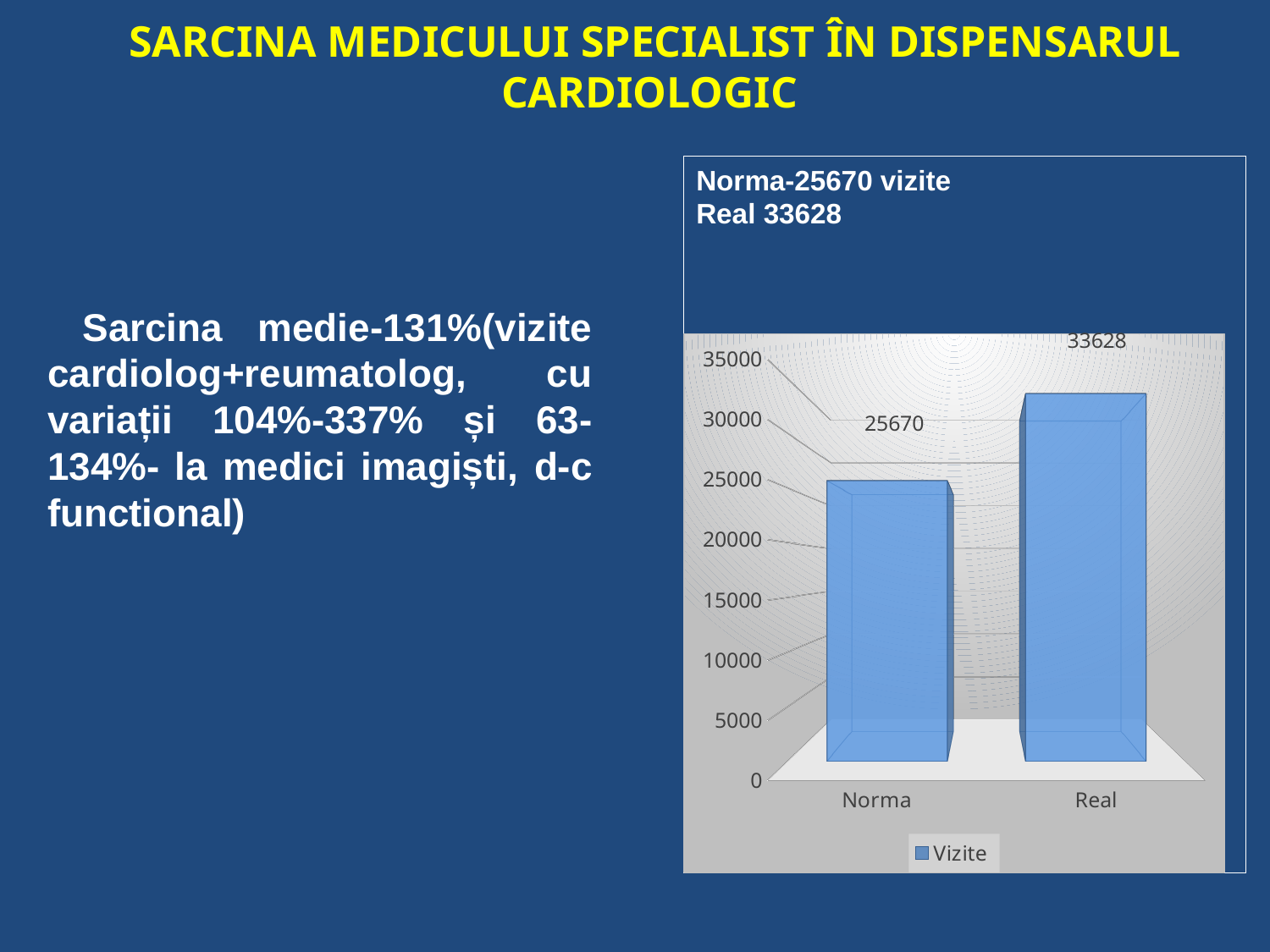
Is the value for Norma greater or less than 30000? less How many categories are shown on the x axis? 2 Is the value for Real greater or less than 30000? greater Which is larger, the value for Norma or the value for Real? Real Which category has the highest value? Real What is the difference between the Real and Norma values? 7958 Which category has the lowest value? Norma What is the value for Norma? 25670 What kind of chart is shown? bar chart What is the value for Real? 33628 How many series does the legend list? 1 What is the name of the series in the legend? Vizite